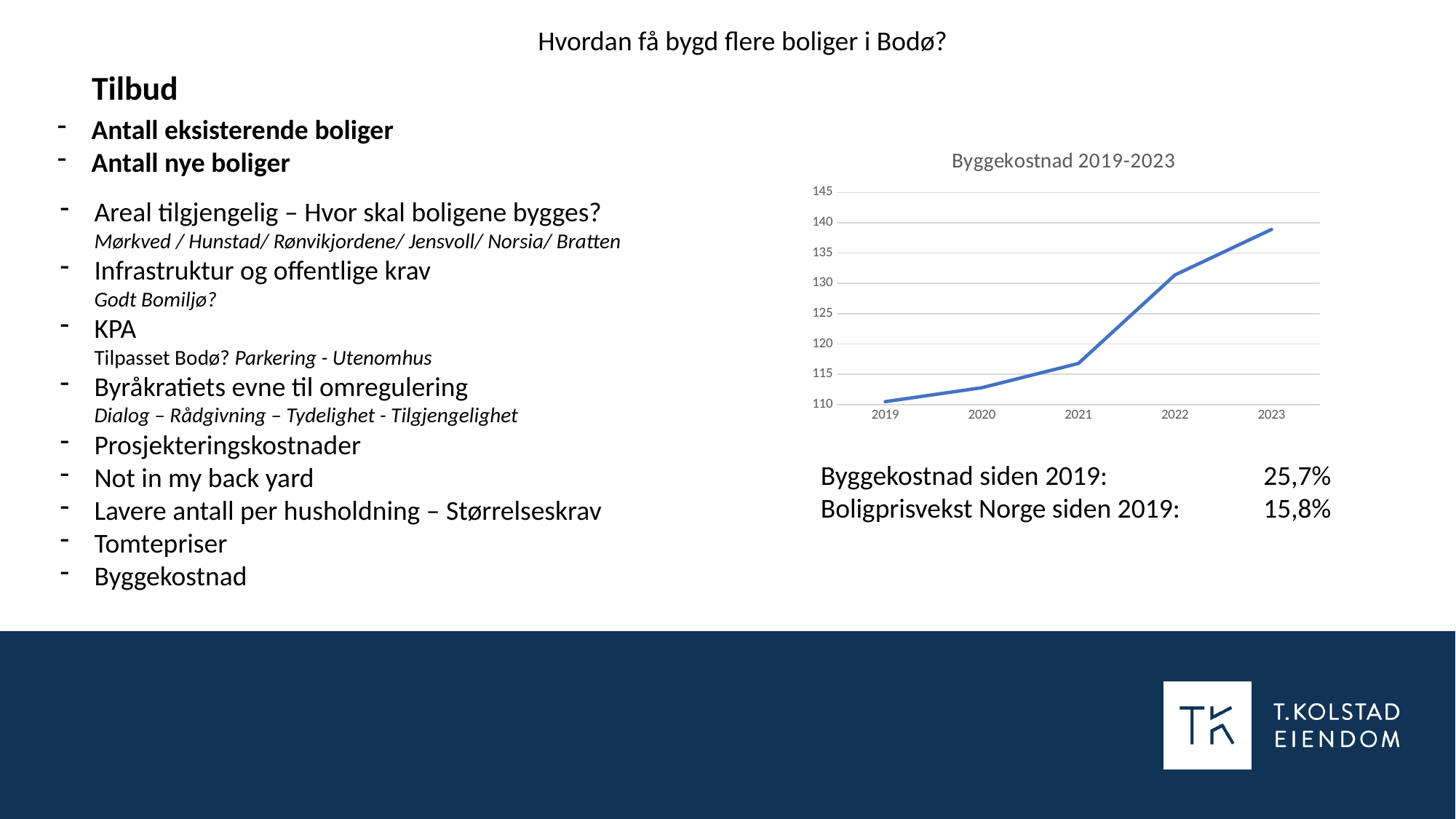
What kind of chart is shown on the slide? line chart How many years are plotted on the x axis of the chart? 5 Is the value for 2023 greater or less than 135? greater What is the title of the chart? Byggekostnad 2019-2023 Which year has the larger value, 2021 or 2022? 2022 Is the value for 2020 greater or less than 115? less Which year has the lowest value in the chart? 2019 Which year has the highest value in the chart? 2023 Is the value for 2022 greater or less than 125? greater Do the values in the chart rise or fall from 2019 to 2023? rise What is the lowest value shown on the chart's y axis? 110